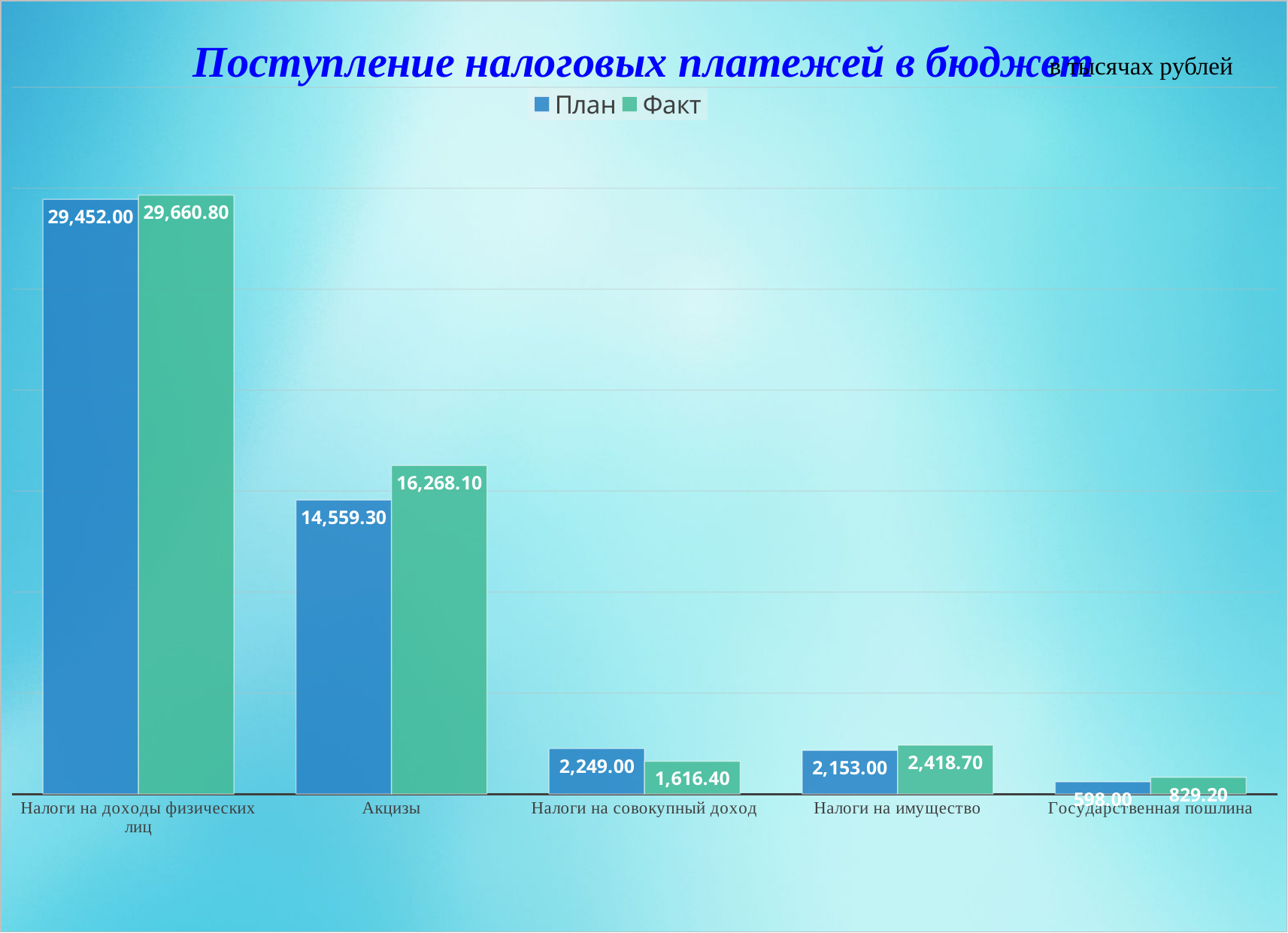
Which category has the lowest План value? Государственная пошлина What is the Факт value for Налоги на доходы физических лиц? 29,660.80 How many series does the legend list? 2 What is the План value for Налоги на совокупный доход? 2,249.00 What is the difference between the Факт and План values for Акцизы? 1,708.80 What is the title of the chart? Поступление налоговых платежей в бюджет What is the План value for Акцизы? 14,559.30 For Налоги на совокупный доход, which is larger: План or Факт? План What is the Факт value for Налоги на имущество? 2,418.70 How many categories are shown on the x axis? 5 What type of chart is shown on the slide? bar chart Which category has the highest Факт value? Налоги на доходы физических лиц